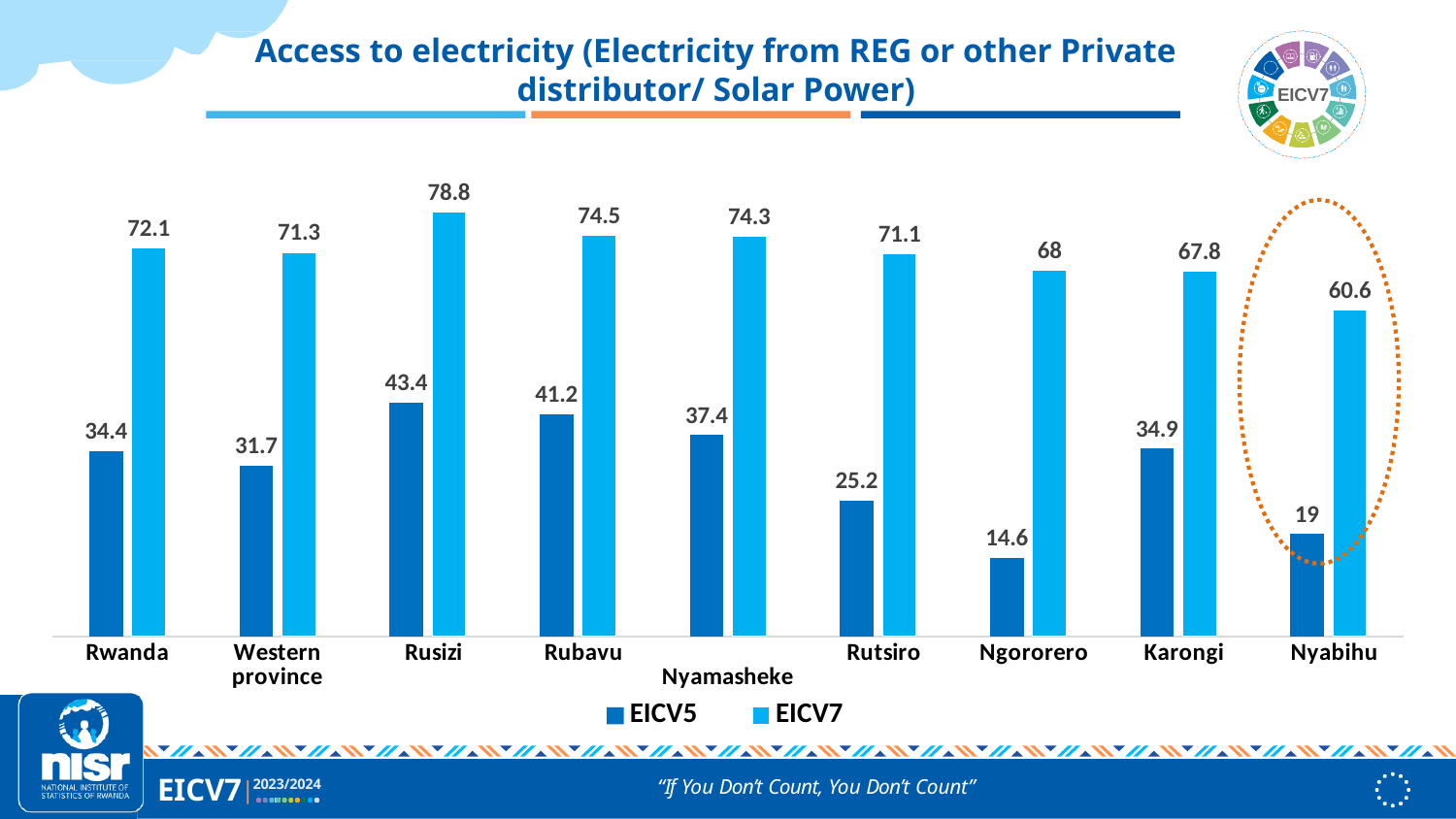
Which is larger, the EICV5 value for Rusizi or the EICV5 value for Rubavu? Rusizi How many series does the legend list? 2 What kind of chart is shown on the slide? Bar chart Which category is highlighted with a dotted orange circle? Nyabihu Which category has the lowest EICV5 value? Ngororero What is the EICV7 value for Nyabihu? 60.6 Which category has the highest EICV7 value? Rusizi What is the EICV5 value for Ngororero? 14.6 What is the difference between the EICV7 and EICV5 values for Nyabihu? 41.6 How many categories are shown on the x axis? 9 What is the EICV7 value for Rusizi? 78.8 What is the EICV5 value for Rwanda? 34.4